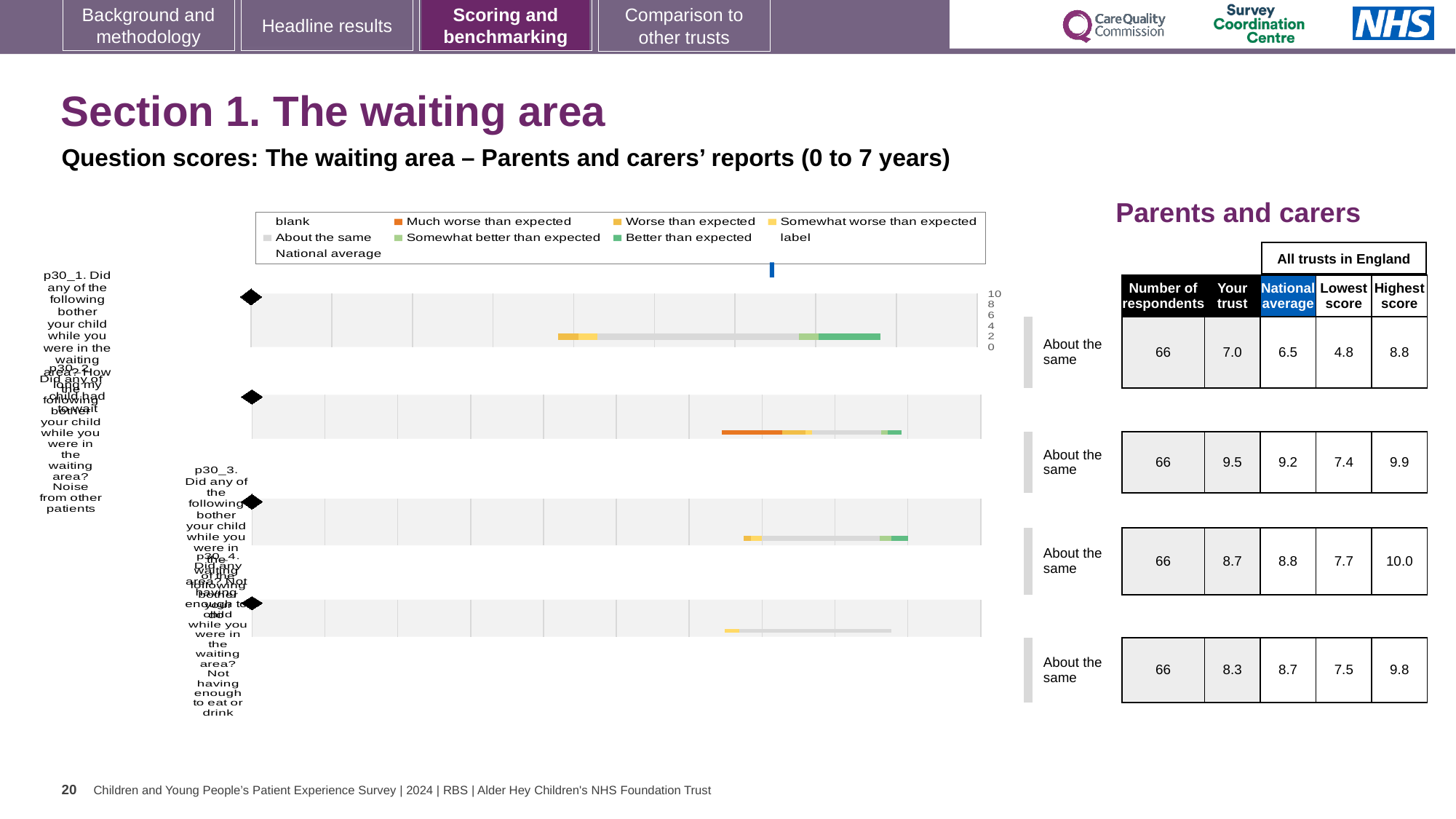
How many question bars are plotted in the chart? 4 Which of the four questions has the lowest 'Your trust' score? p30_1 (how long had to wait) What kind of chart is shown on the slide? bar chart What is the difference between the 'Your trust' score and the national average for the first question (p30_1)? 0.5 What is the 'Your trust' score for the first question (p30_1, bother in the waiting area: how long had to wait)? 7.0 What is the highest score across all trusts for the fourth question (p30_4, not having enough to eat or drink)? 9.8 Which colour does the legend use for 'Much worse than expected'? orange Is the 'Your trust' score for the second question (p30_2) greater or less than the national average? greater What is the national average for the second question (p30_2, noise from other patients)? 9.2 What is the 'Your trust' score for the third question (p30_3, not having enough to do)? 8.7 Which of the four questions has the highest 'Your trust' score? p30_2 (noise from other patients) What is the highest value shown on the chart's axis? 10